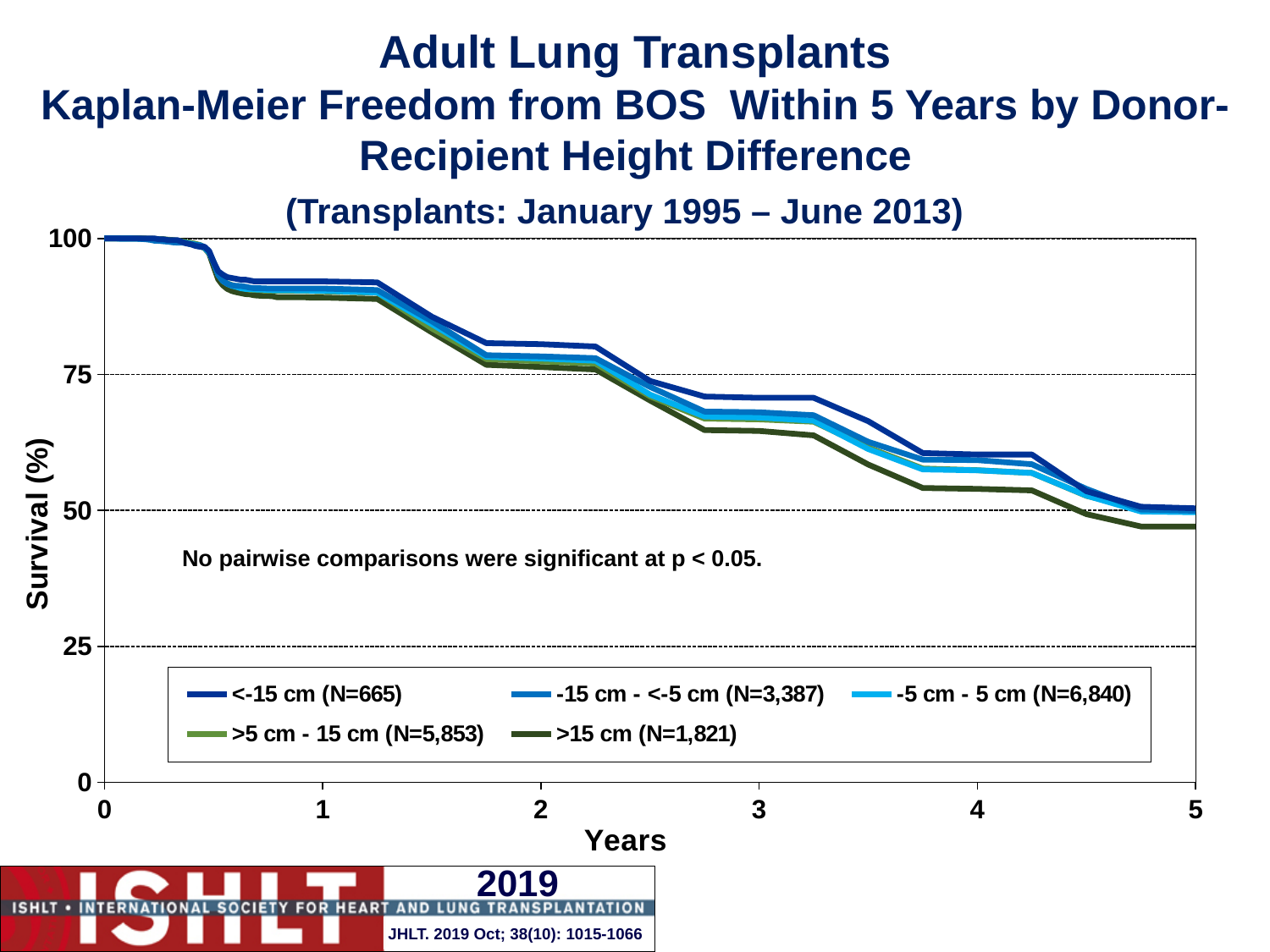
Is the value for the >15 cm group at year 5 greater or less than 50? less Which group has the lowest survival at year 5? >15 cm (N=1,821) Do the survival curves rise or fall as years increase? fall What is the label of the y axis? Survival (%) How many series does the legend list? 5 What is the survival value for the <-15 cm group at year 0? 100 Is the value for the >15 cm group at year 4 greater or less than 50? greater What is the N for the -5 cm - 5 cm group shown in the legend? 6,840 At year 5, which group has the larger survival value, <-15 cm or >15 cm? <-15 cm What kind of chart is shown on the slide? line chart Is the value for the <-15 cm group at year 2 greater or less than 75? greater Which group has the highest survival at year 3? <-15 cm (N=665)